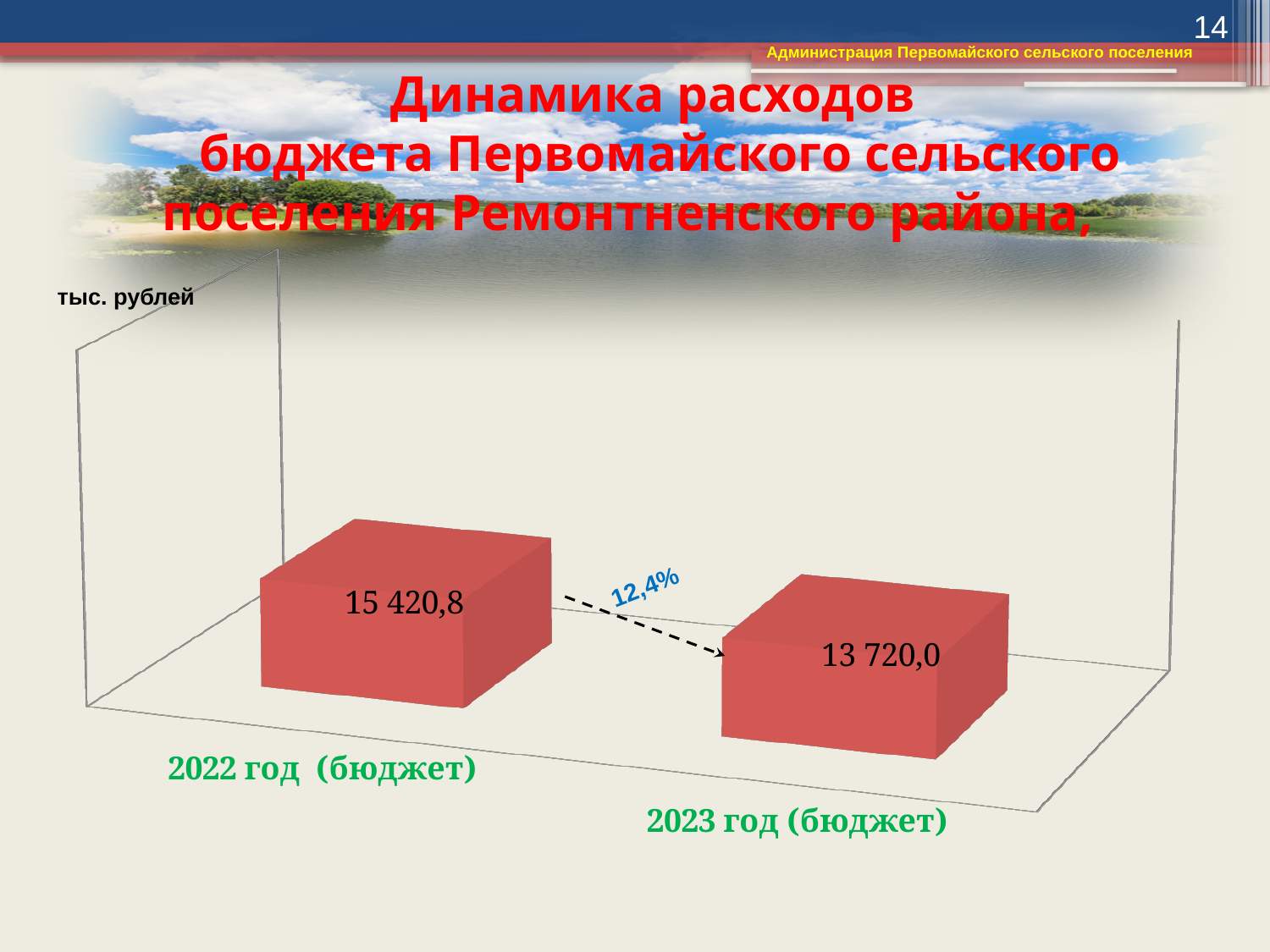
What is the value for 2023 год (бюджет)? 13 720,0 What percentage change is labelled on the arrow between the two bars? 12,4% What unit of measurement is indicated on the chart? тыс. рублей What kind of chart is shown on the slide? bar chart Which is larger, the value for 2022 год (бюджет) or for 2023 год (бюджет)? 2022 год (бюджет) Which category has the lowest value? 2023 год (бюджет) What is the value for 2022 год (бюджет)? 15 420,8 Do the values rise or fall from 2022 to 2023? fall Which category has the highest value? 2022 год (бюджет) How many categories are shown in the chart? 2 What is the difference between the values for 2022 год (бюджет) and 2023 год (бюджет)? 1 700,8